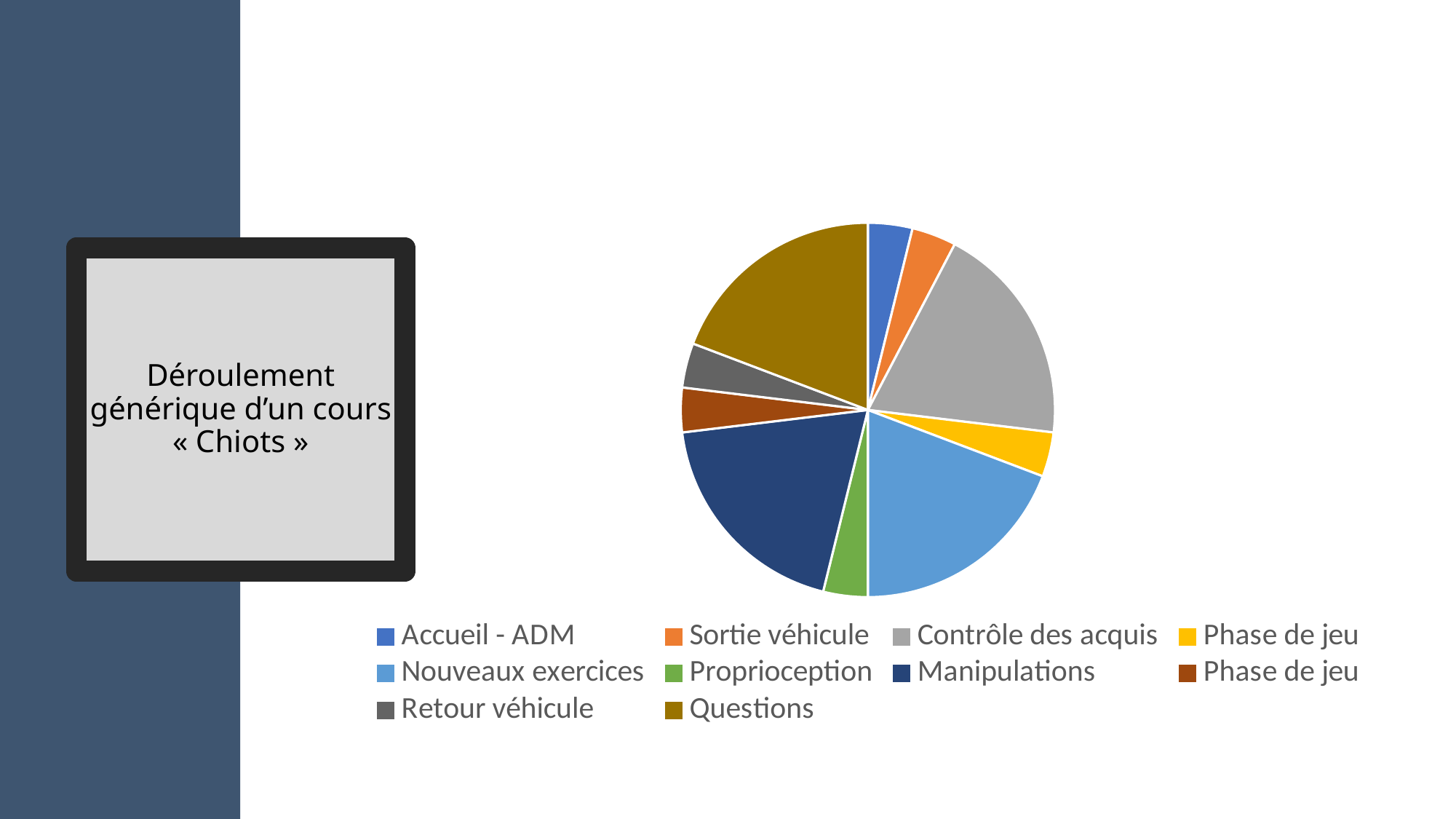
What kind of chart is shown on the slide? pie chart Which slice is larger, Contrôle des acquis or Accueil - ADM? Contrôle des acquis Which slice is larger, Nouveaux exercices or Sortie véhicule? Nouveaux exercices Which slice is larger, Manipulations or Proprioception? Manipulations Which legend label appears twice in the pie chart's legend? Phase de jeu How many slices does the pie chart have? 10 What colour is the Questions slice of the pie chart? dark yellow (gold) How many entries does the legend of the pie chart list? 10